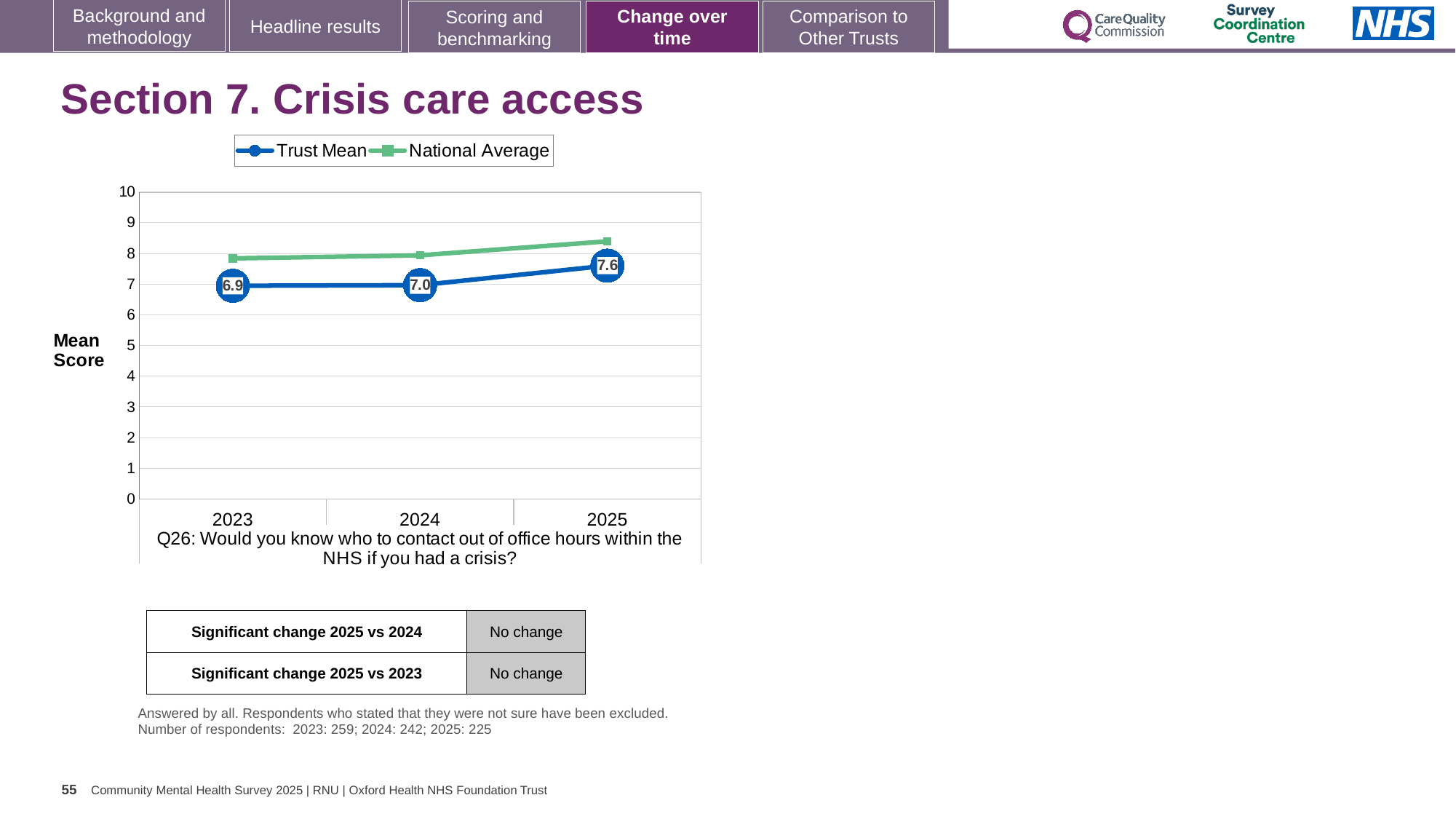
Which is larger in 2025, the Trust Mean or the National Average? National Average What is the Trust Mean for 2023? 6.9 In which year is the Trust Mean lowest? 2023 In which year is the Trust Mean highest? 2025 What is the Trust Mean for 2025? 7.6 What is the difference between the Trust Mean in 2025 and in 2023? 0.7 What is the Trust Mean for 2024? 7.0 How many years are shown on the x axis? 3 Is the National Average for 2025 greater or less than 8? greater How many series does the legend list? 2 Does the Trust Mean rise or fall from 2023 to 2025? rise What kind of chart is shown? line chart